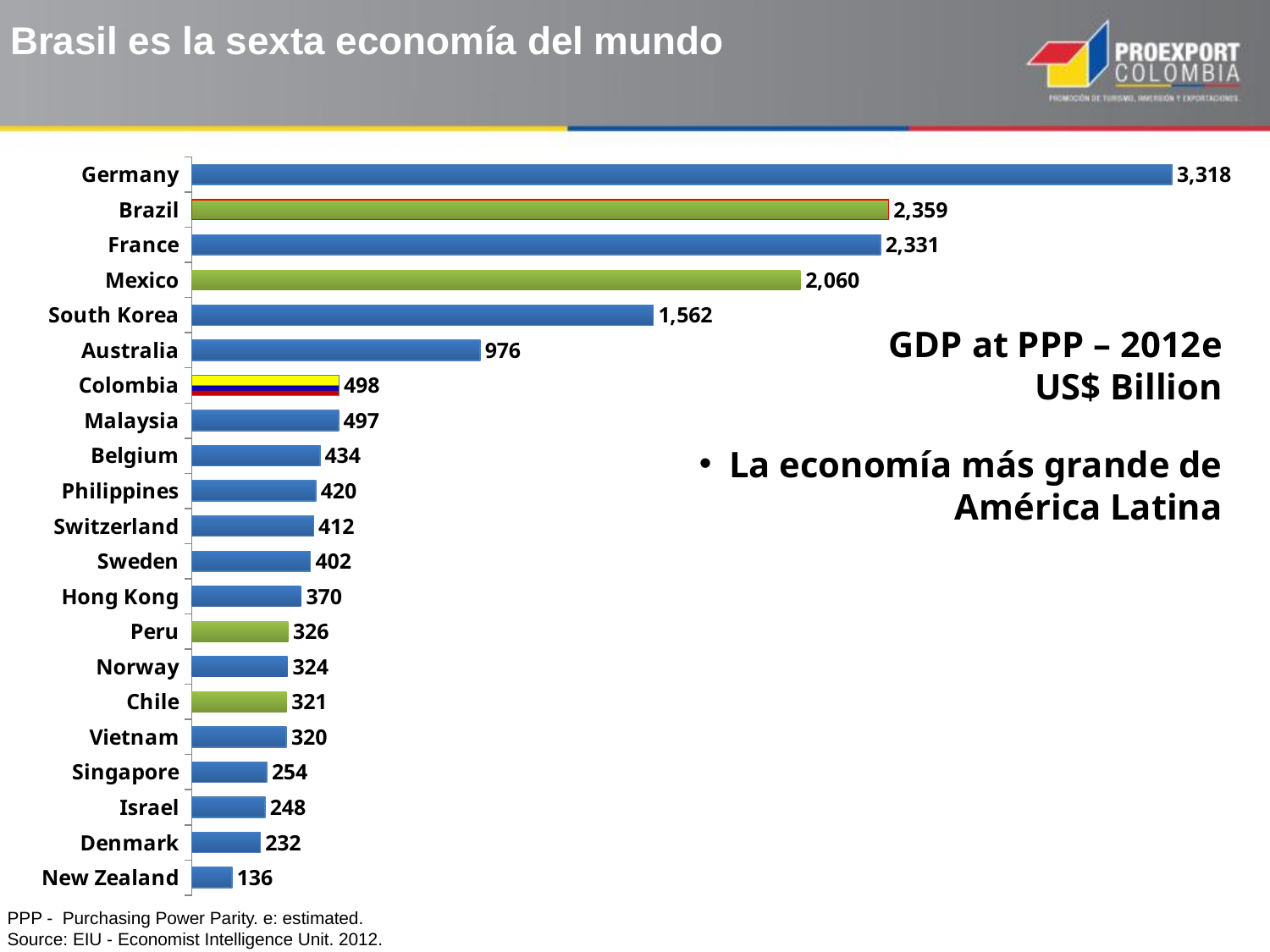
Which has a larger value, France or Mexico? France What is the value shown for South Korea? 1,562 What is the difference between the values for Mexico and Peru? 1,734 What is the GDP at PPP value shown for Brazil? 2,359 Which country has the highest value in the chart? Germany What type of chart is shown on the slide? Bar chart Which has a larger value, Australia or Hong Kong? Australia What is the difference between the values for Germany and Brazil? 959 What is the value shown for Colombia? 498 What unit is stated for the GDP at PPP values in the chart? US$ Billion Which country has the lowest value in the chart? New Zealand How many countries are shown in the chart? 21